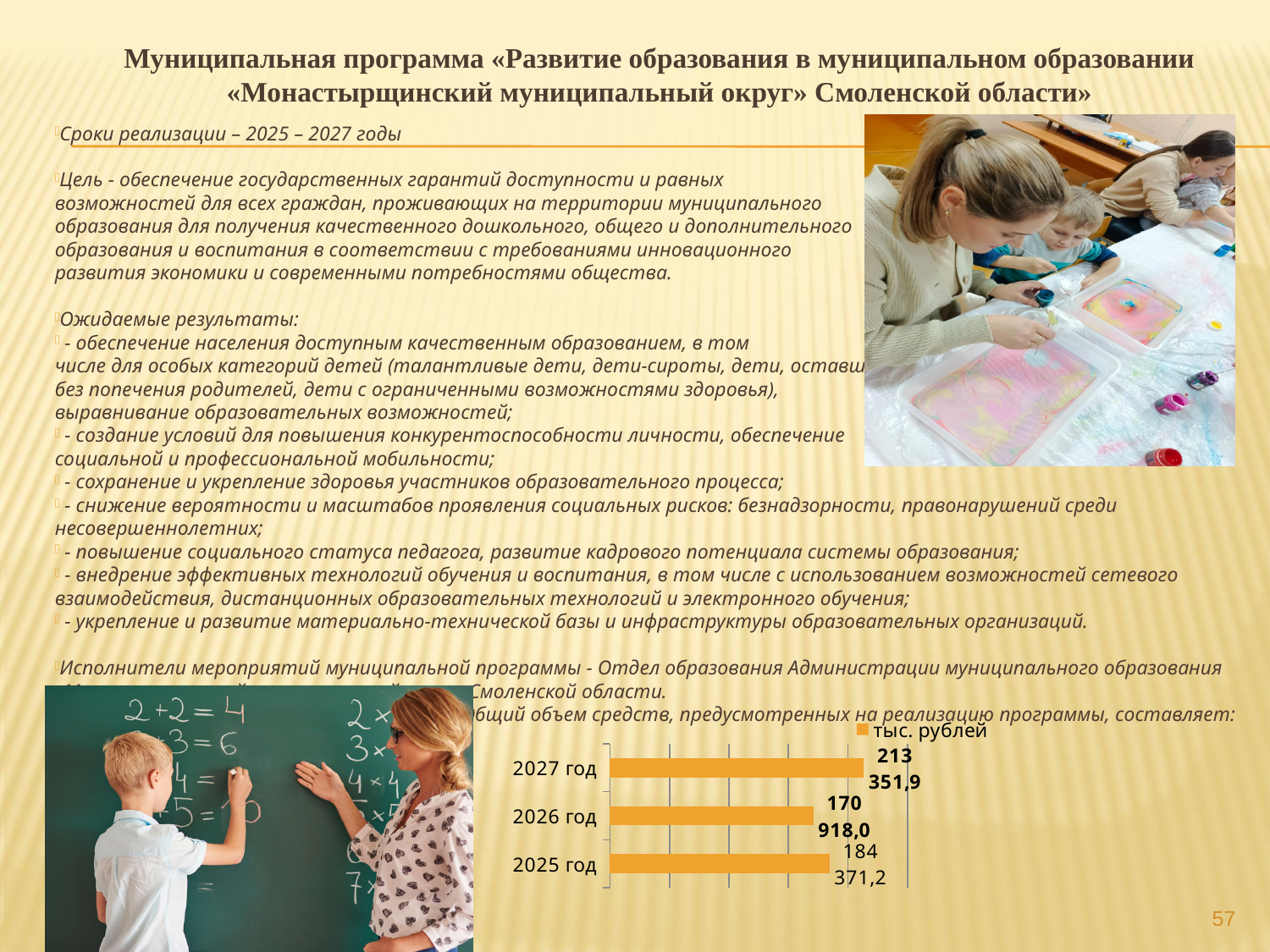
Which year has the lowest value on the chart? 2026 год What is the value for 2026 год on the chart? 170 918,0 What is the difference between the values for 2025 год and 2026 год? 13 453,2 Which is larger, the value for 2025 год or the value for 2026 год? 2025 год What is the value for 2025 год on the chart? 184 371,2 What kind of chart is shown on the slide? Bar chart How many series does the chart legend list? 1 Which year has the highest value on the chart? 2027 год What is the value for 2027 год on the chart? 213 351,9 How many categories (years) are shown on the chart? 3 What is the difference between the values for 2027 год and 2025 год? 28 980,7 What is the legend entry of the chart? тыс. рублей